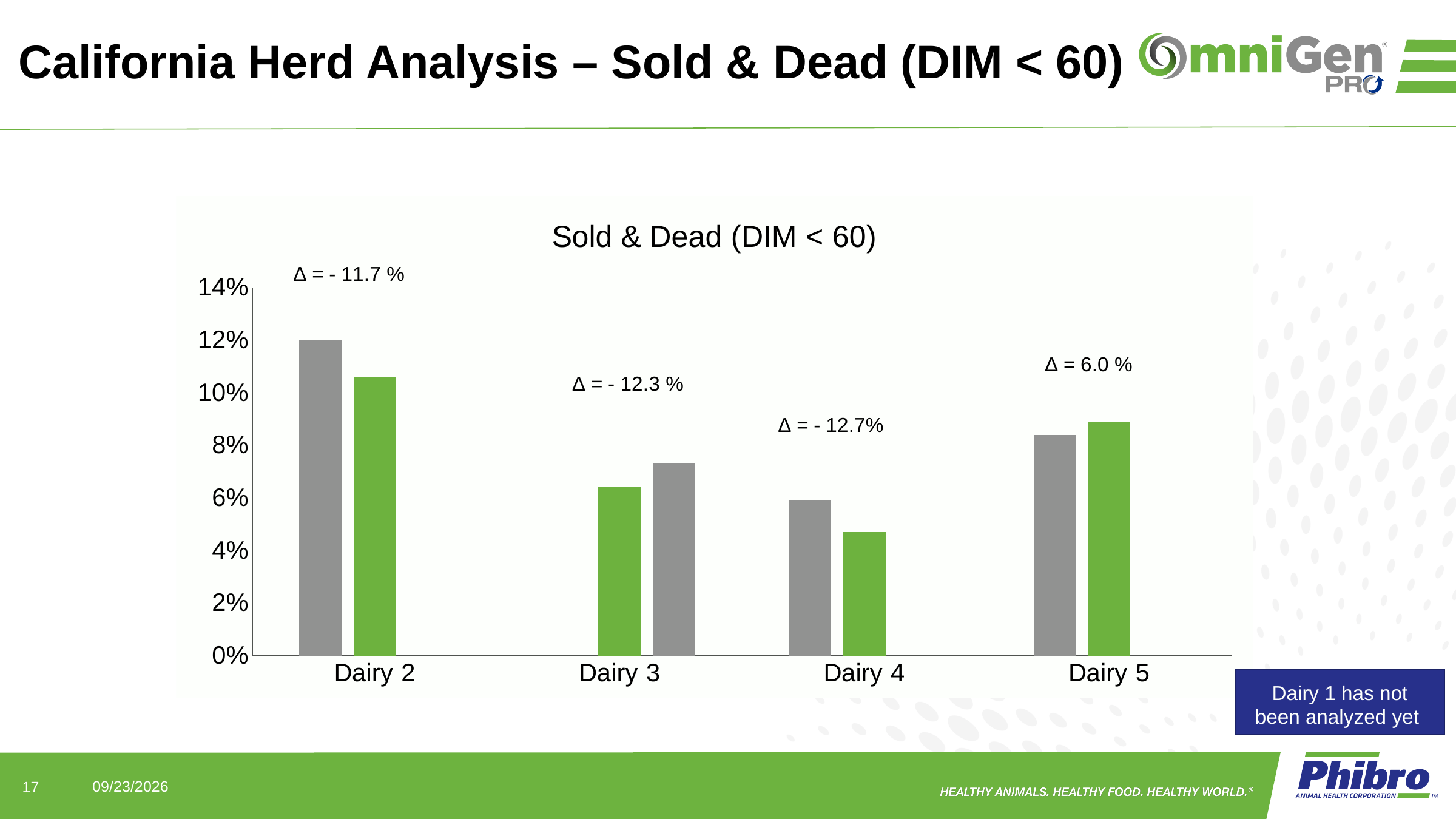
What delta (Δ) value is printed above the bars for Dairy 3? Δ = - 12.3 % For Dairy 2, is the green bar greater or less than 10%? greater For Dairy 5, which bar is taller, the gray bar or the green bar? the green bar For Dairy 4, is the green bar greater or less than 6%? less Which dairy has the tallest bar on the chart? Dairy 2 What delta (Δ) value is printed above the bars for Dairy 5? Δ = 6.0 % How many dairies are shown on the x axis of the chart? 4 What delta (Δ) value is printed above the bars for Dairy 2? Δ = - 11.7 % Which dairy has the only positive delta (Δ) value printed on the chart? Dairy 5 What delta (Δ) value is printed above the bars for Dairy 4? Δ = - 12.7% What is the title of the chart? Sold & Dead (DIM < 60) What kind of chart is shown on the slide? bar chart